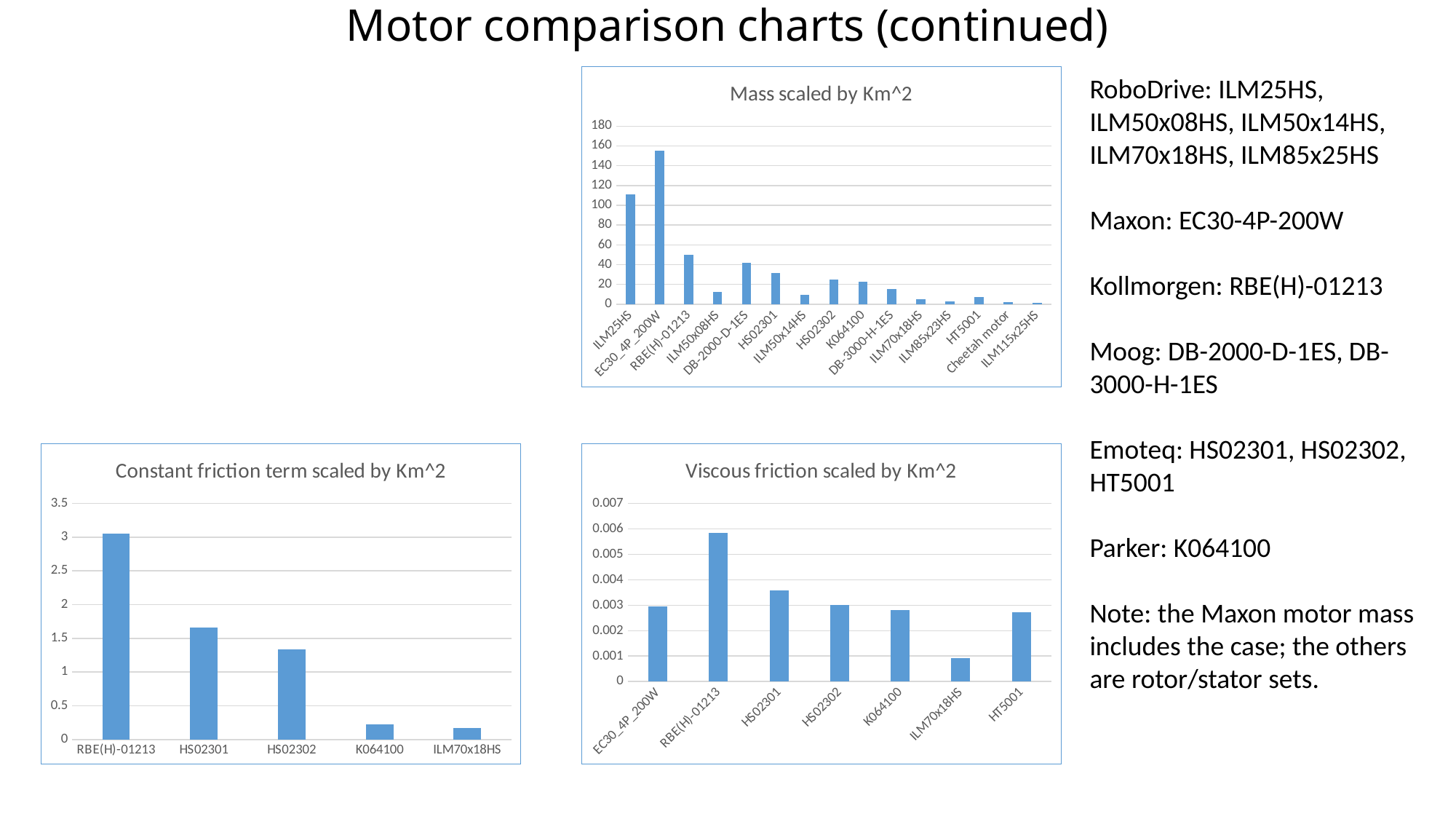
In the 'Viscous friction scaled by Km^2' chart, which motor has the lowest value? ILM70x18HS In the 'Viscous friction scaled by Km^2' chart, is the value for RBE(H)-01213 greater or less than 0.005? greater In the 'Constant friction term scaled by Km^2' chart, which motor has the highest value? RBE(H)-01213 How many motors are shown in the 'Constant friction term scaled by Km^2' chart? 5 In the 'Mass scaled by Km^2' chart, which is larger, the value for ILM25HS or the value for RBE(H)-01213? ILM25HS How many motors are shown in the 'Mass scaled by Km^2' chart? 15 In the 'Mass scaled by Km^2' chart, which motor has the highest value? EC30_4P_200W In the 'Constant friction term scaled by Km^2' chart, which is larger, the value for HS02301 or the value for HS02302? HS02301 In the 'Mass scaled by Km^2' chart, is the value for EC30_4P_200W greater or less than 140? greater In the 'Mass scaled by Km^2' chart, is the value for ILM25HS greater or less than 100? greater What kind of chart is the 'Viscous friction scaled by Km^2' chart? bar chart